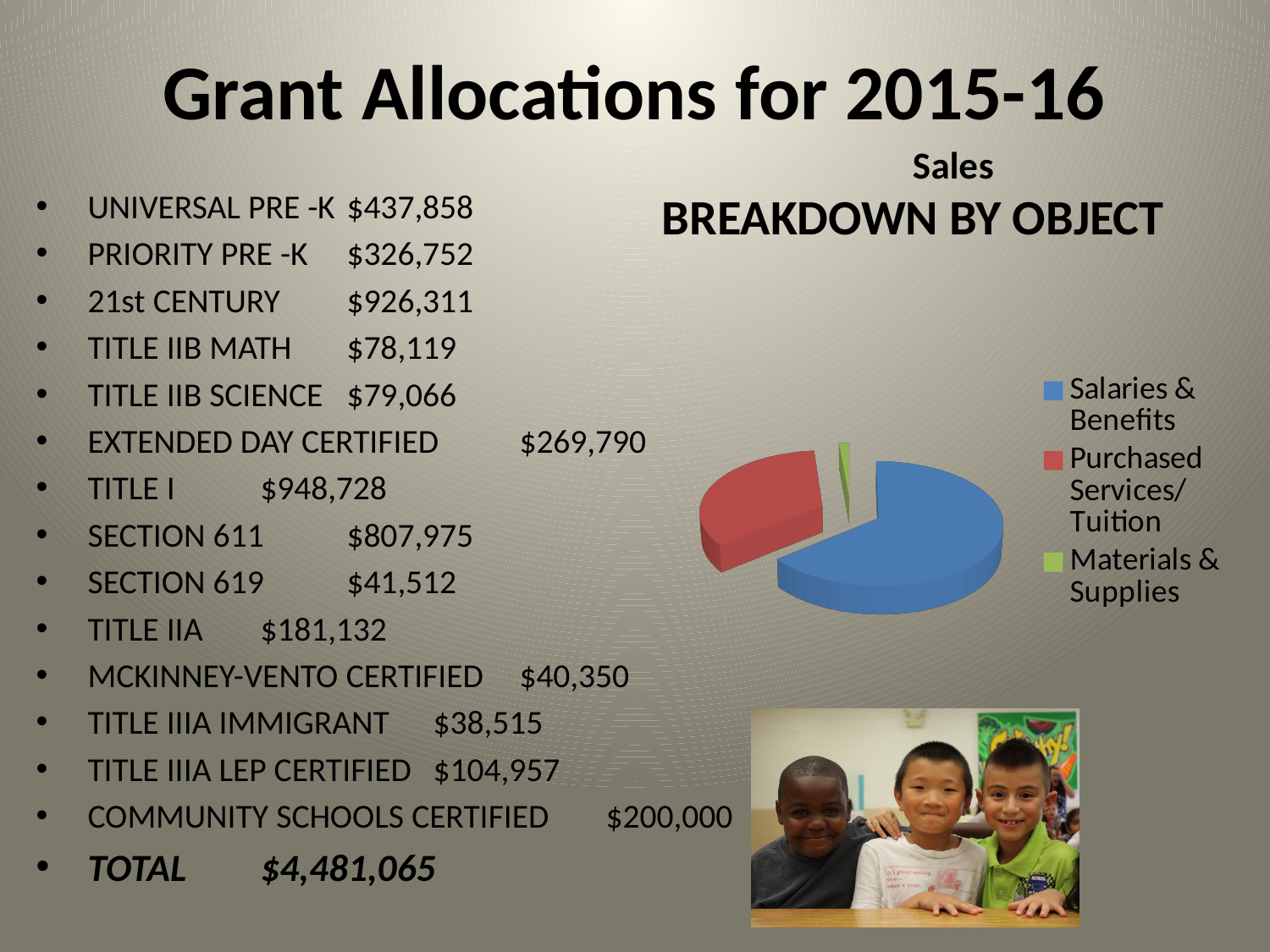
Which category has the largest slice of the pie chart? Salaries & Benefits Which slice is larger in the pie chart: Purchased Services/Tuition or Materials & Supplies? Purchased Services/Tuition What is the title of the pie chart? Sales Which category has the smallest slice of the pie chart? Materials & Supplies What kind of chart is shown on the slide? pie chart Which colour represents Materials & Supplies in the pie chart? green Which slice is larger in the pie chart: Salaries & Benefits or Purchased Services/Tuition? Salaries & Benefits How many entries does the pie chart's legend list? 3 How many slices does the pie chart have? 3